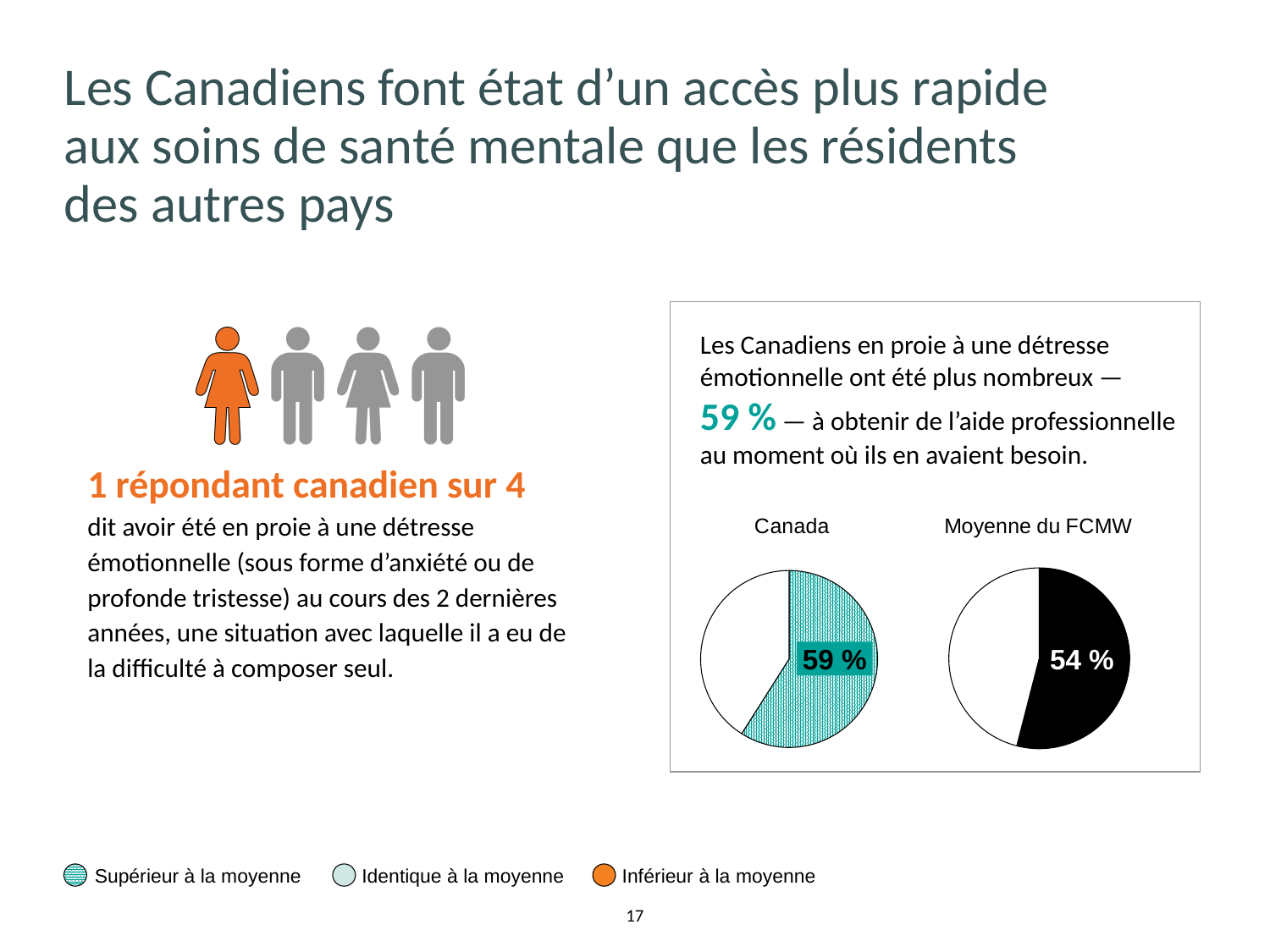
Is the highlighted share in the Canada pie chart greater or less than 50 %? greater How many pie charts are shown on the slide? 2 What kind of chart is used to show the Canada and Moyenne du FCMW values? Pie chart In the Canada pie chart, what share is shown for the highlighted slice? 59 % According to the pictogram of people on the left, how many Canadian respondents out of 4 reported emotional distress? 1 sur 4 What is the label of the pie chart on the right inside the boxed panel? Moyenne du FCMW How many person icons are shown in the pictogram on the left of the slide? 4 Which pie chart shows the larger highlighted share, Canada or Moyenne du FCMW? Canada What is the difference between the Canada value and the Moyenne du FCMW value in the pie charts? 5 % Is the highlighted share in the Moyenne du FCMW pie chart greater or less than 60 %? less What is the label of the pie chart on the left inside the boxed panel? Canada In the Moyenne du FCMW pie chart, what share is shown for the highlighted slice? 54 %